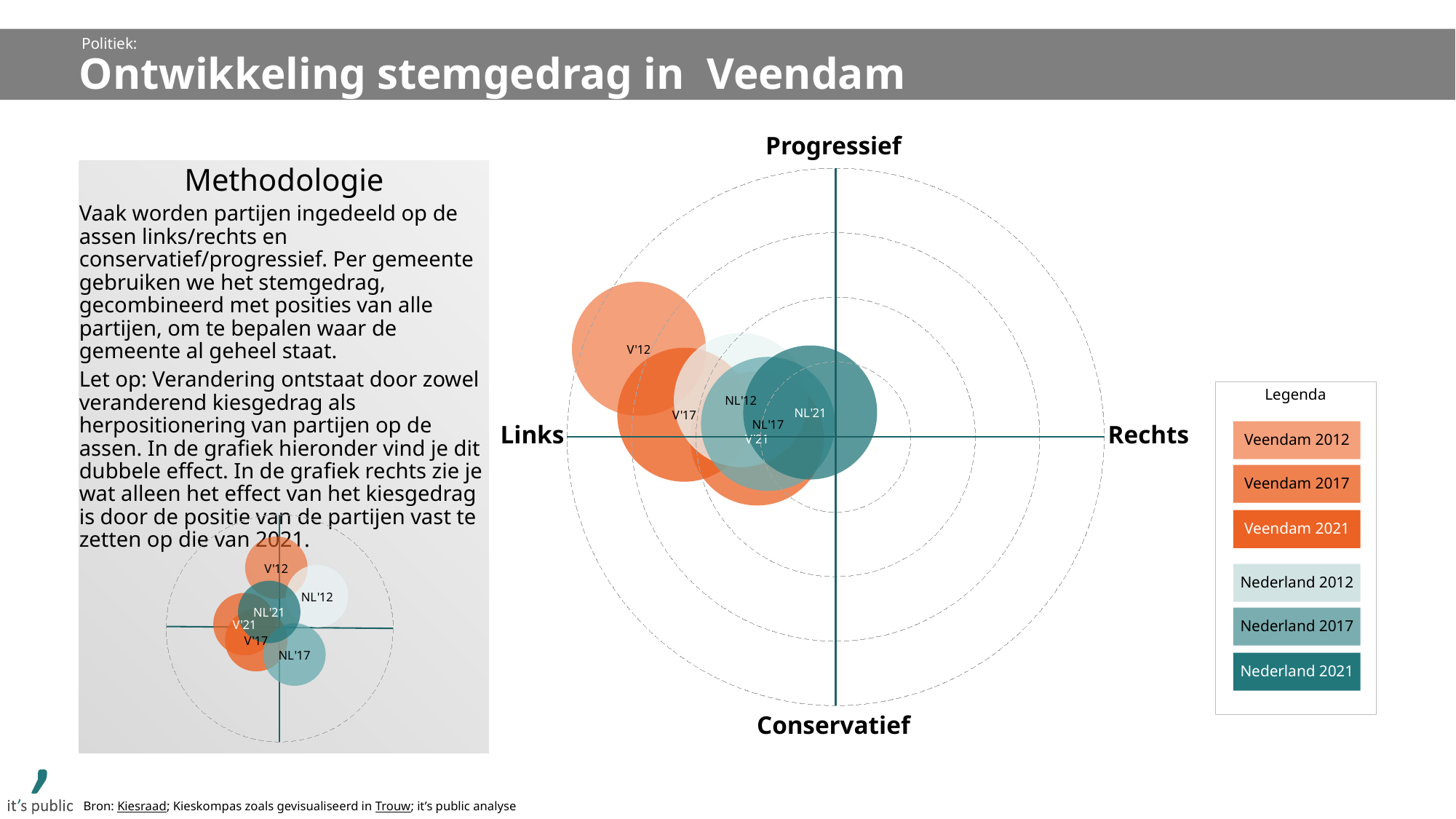
In the large chart on the right, which bubble is positioned furthest to the left (most 'Links')? V'12 In the large chart on the right, what is the label at the left end of the horizontal axis? Links In the large chart on the right, what is the label at the top of the vertical axis? Progressief In the large chart on the right, which bubble is the largest in size? V'12 In the large chart on the right, which bubble is further to the left: V'12 or NL'21? V'12 How many entries does the legend (Legenda) list? 6 What kind of chart is the large chart on the right of the slide? Bubble chart In the large chart on the right, which bubble is positioned furthest to the right (most 'Rechts')? NL'21 How many labelled bubbles are plotted in the large chart on the right? 6 In the large chart on the right, do the Veendam bubbles move toward the left or toward the centre from V'12 to V'21? Toward the centre In the small chart at the bottom left, which bubble is positioned lowest (most 'Conservatief')? NL'17 In the small chart at the bottom left, which bubble is positioned highest (most 'Progressief')? V'12